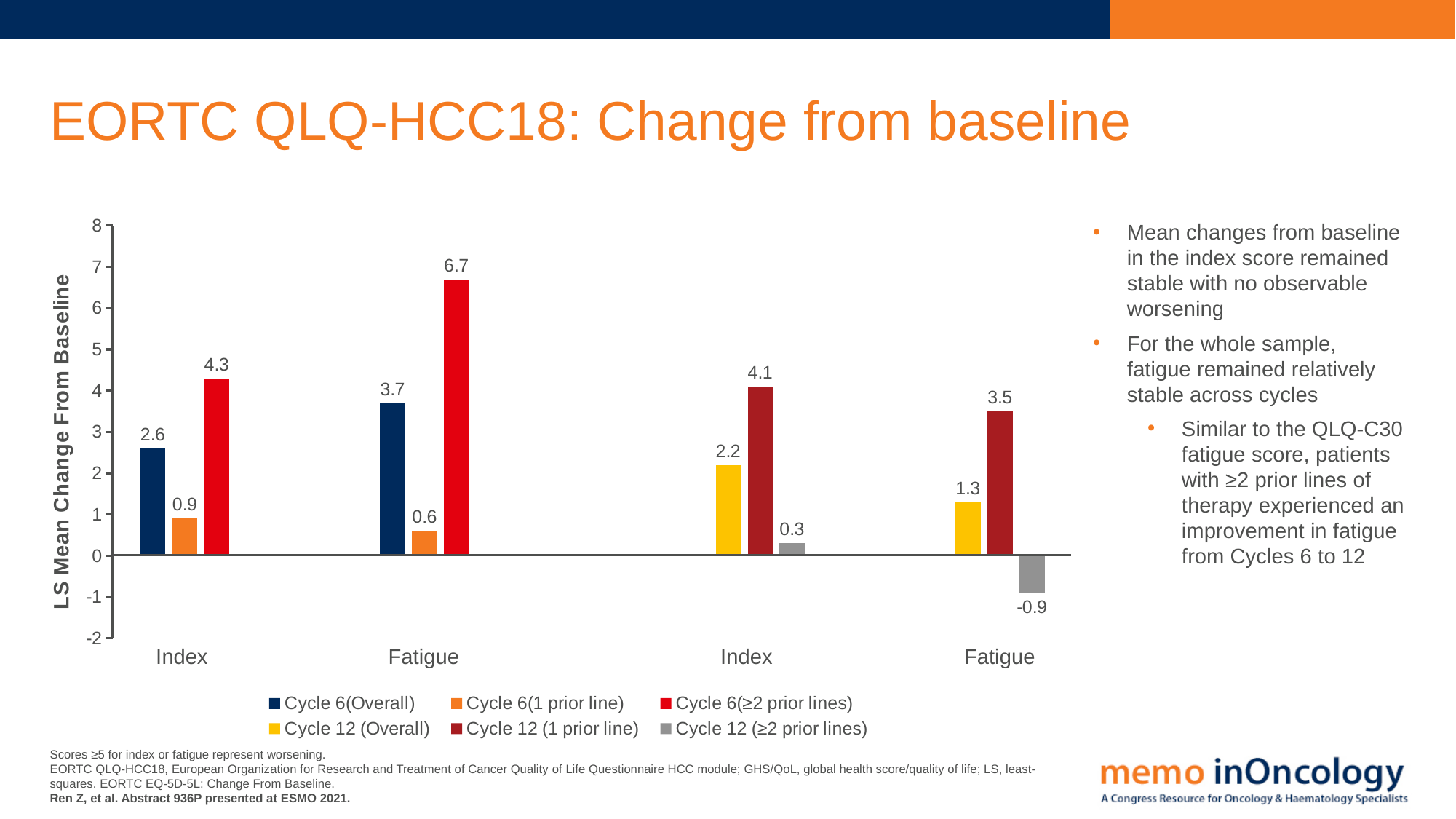
What is the value of the Cycle 6 (Overall) bar for Index? 2.6 What is the value of the Cycle 12 (1 prior line) bar for Index? 4.1 What is the value of the Cycle 6 (≥2 prior lines) bar for Fatigue? 6.7 What is the value of the Cycle 12 (≥2 prior lines) bar for Fatigue? -0.9 Which bar has the highest value on the chart? Cycle 6 (≥2 prior lines), Fatigue Which is larger: the Cycle 6 (Overall) Index value or the Cycle 12 (Overall) Index value? Cycle 6 (Overall) Index Which bar has the lowest value on the chart? Cycle 12 (≥2 prior lines), Fatigue What is the difference between the Cycle 12 (1 prior line) Fatigue value and the Cycle 12 (Overall) Fatigue value? 2.2 What is the difference between the Cycle 6 (≥2 prior lines) Fatigue value and the Cycle 6 (Overall) Fatigue value? 3.0 How many series does the legend list? 6 What kind of chart is shown on the slide? Bar chart What is the label of the y axis? LS Mean Change From Baseline